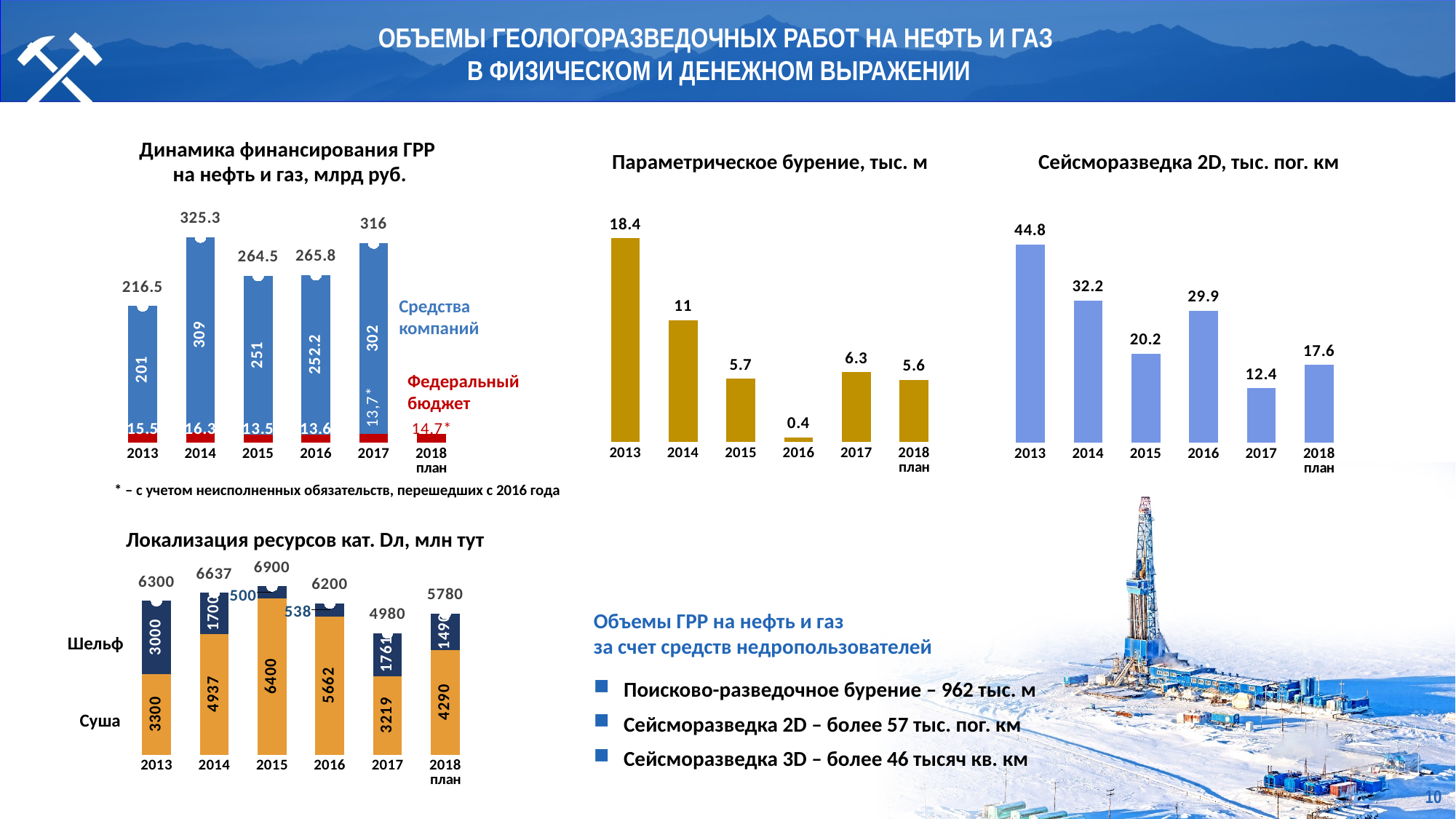
In the chart 'Сейсморазведка 2D, тыс. пог. км', which year has the highest value? 2013 In the chart 'Сейсморазведка 2D, тыс. пог. км', what is the value for 2018 план? 17.6 In the chart 'Динамика финансирования ГРР на нефть и газ, млрд руб.', what is the 'Федеральный бюджет' value for 2015? 13.5 In the chart 'Параметрическое бурение, тыс. м', what is the value for 2013? 18.4 In the chart 'Локализация ресурсов кат. Dл, млн тут', how many series does the chart show? 2 In the chart 'Локализация ресурсов кат. Dл, млн тут', what is the total for 2017? 4980 In the chart 'Сейсморазведка 2D, тыс. пог. км', what is the difference between the 2016 and 2017 values? 17.5 In the chart 'Параметрическое бурение, тыс. м', which year has the lowest value? 2016 In the chart 'Динамика финансирования ГРР на нефть и газ, млрд руб.', what is the total for 2014? 325.3 In the chart 'Динамика финансирования ГРР на нефть и газ, млрд руб.', which is larger: 'Средства компаний' in 2016 or in 2017? 2017 What kind of chart is 'Параметрическое бурение, тыс. м'? Bar chart In the chart 'Локализация ресурсов кат. Dл, млн тут', what is the 'Суша' value for 2015? 6400